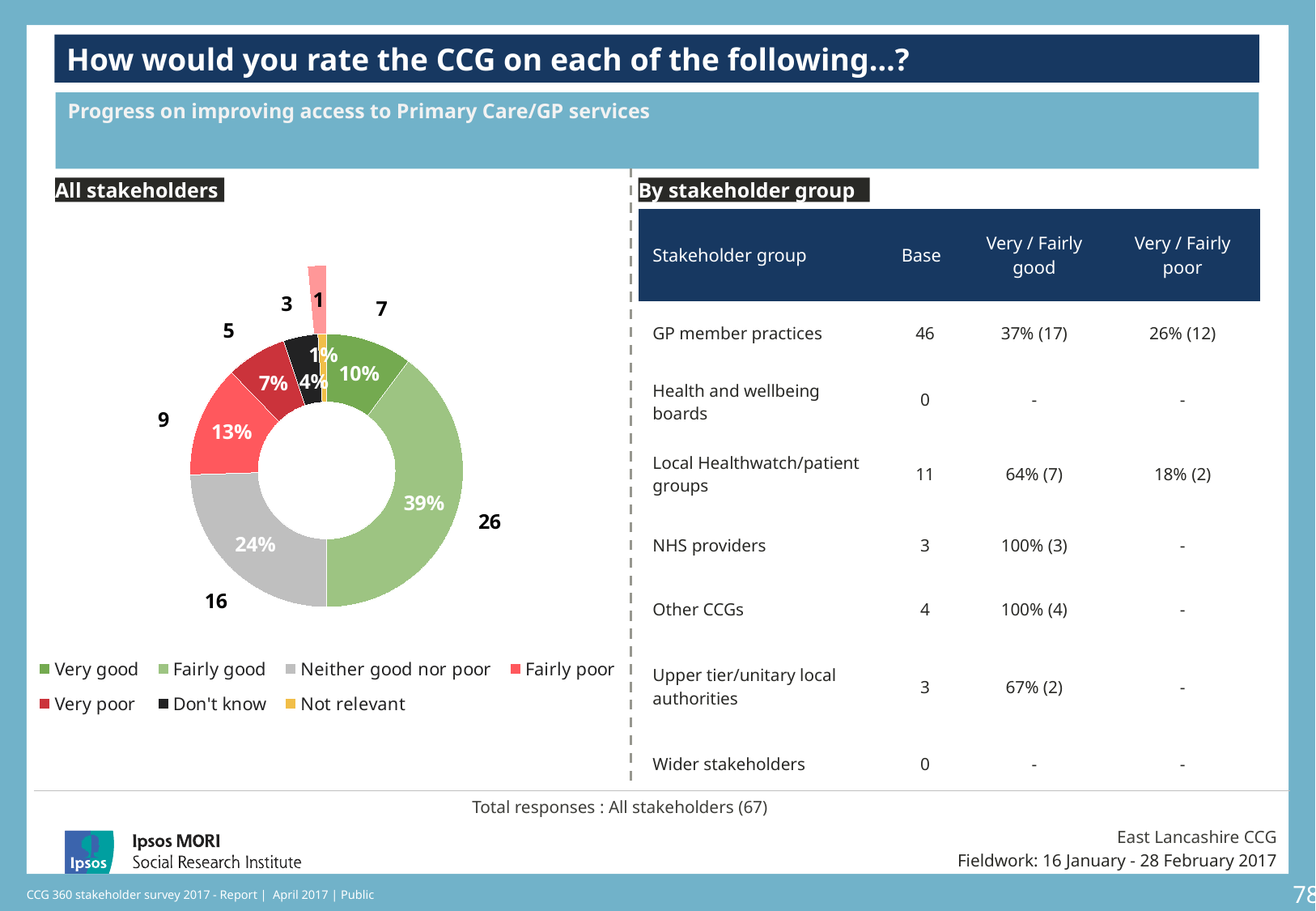
What type of chart is shown under 'All stakeholders'? Donut (pie) chart In the donut chart, what is the difference in percentage points between Fairly good and Neither good nor poor? 15 In the donut chart, how many respondents rated the CCG as Very poor? 5 In the donut chart, what percentage of all stakeholders rated the CCG as Neither good nor poor? 24% In the donut chart, which is larger: the share for Fairly poor or the share for Very poor? Fairly poor In the donut chart, what percentage of all stakeholders rated the CCG as Very good? 10% In the donut chart, how many respondents answered Don't know? 3 In the donut chart, what percentage of all stakeholders rated the CCG as Fairly poor? 13% How many categories does the legend of the donut chart list? 7 In the donut chart, what percentage of all stakeholders rated the CCG as Fairly good? 39% Which rating category has the smallest share in the donut chart? Not relevant Which rating category has the largest share in the donut chart? Fairly good